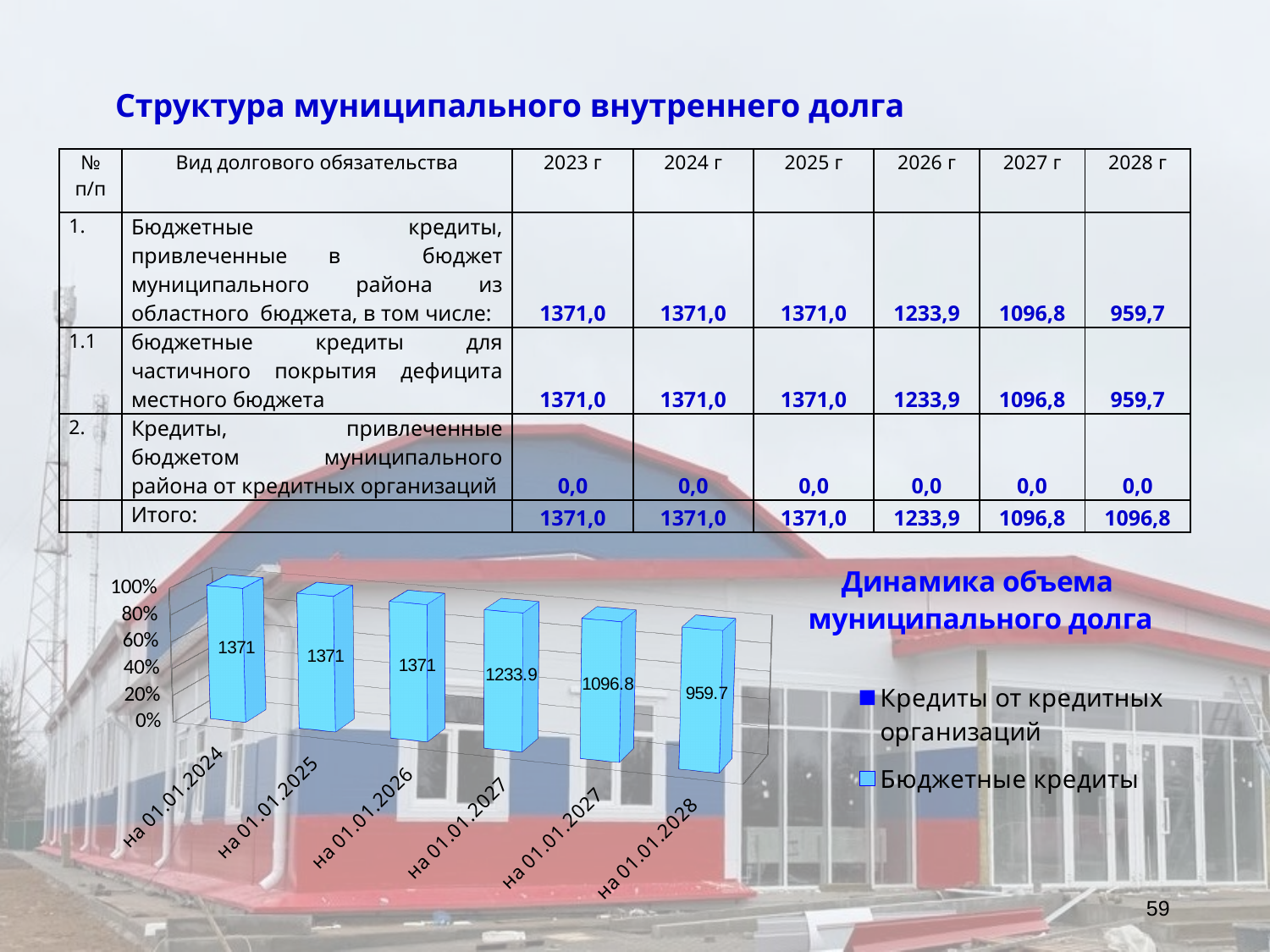
Do the labelled values rise or fall from left to right along the x axis? fall What kind of chart is shown on the slide? bar chart How many bars are plotted in the chart? 6 How many series does the chart legend list? 2 Which category has the lowest labelled value in the chart? на 01.01.2028 What value is labelled on the bar for на 01.01.2028? 959.7 Which legend entry is shown in light blue? Бюджетные кредиты What is the title of the chart? Динамика объема муниципального долга What value is labelled on the bar for на 01.01.2024? 1371 What value is labelled on the bar for на 01.01.2026? 1371 Which is larger: the labelled value for на 01.01.2025 or for на 01.01.2028? на 01.01.2025 What is the difference between the labelled values for на 01.01.2024 and на 01.01.2028? 411.3